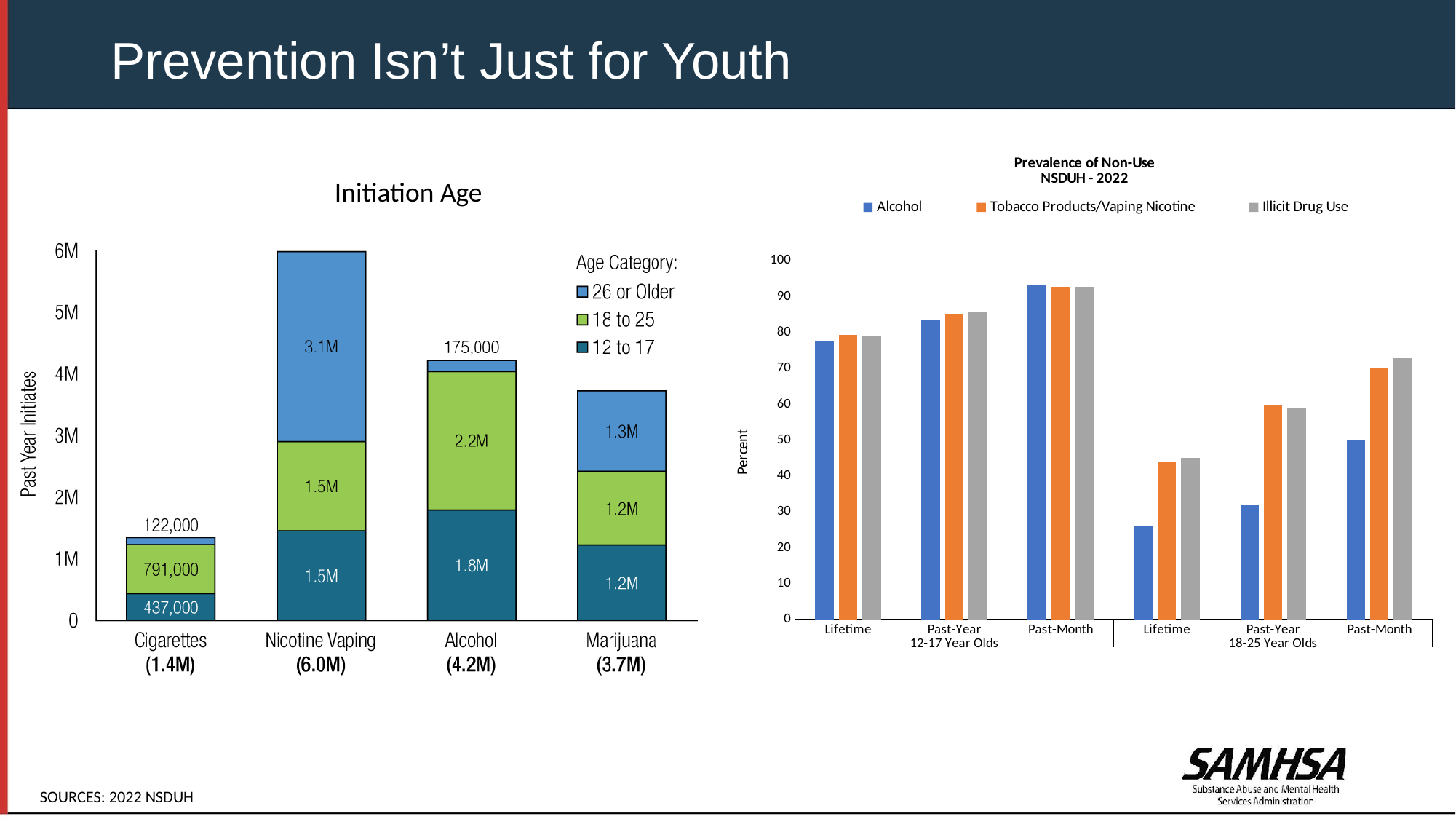
What kind of chart is the Prevalence of Non-Use chart? Bar chart In the Initiation Age chart, how many age categories does the legend list? 3 In the Prevalence of Non-Use chart, is the Alcohol value for Lifetime among 18-25 Year Olds greater or less than 30? less In the Initiation Age chart, what is the value for the 26 or Older age category for Alcohol? 175,000 In the Initiation Age chart, what is the total number of past year initiates for Nicotine Vaping? 6.0M In the Initiation Age chart, what is the difference between the 18 to 25 and 12 to 17 values for Alcohol? 0.4M In the Initiation Age chart, which substance has the lowest total number of past year initiates? Cigarettes In the Initiation Age chart, what is the value for the 12 to 17 age category for Cigarettes? 437,000 In the Initiation Age chart, which substance has the highest total number of past year initiates? Nicotine Vaping In the Initiation Age chart, how many past year initiates of Nicotine Vaping were 26 or Older? 3.1M In the Prevalence of Non-Use chart, is the Alcohol value for Lifetime higher for 12-17 Year Olds or 18-25 Year Olds? 12-17 Year Olds In the Initiation Age chart, how many substances are shown on the x axis? 4